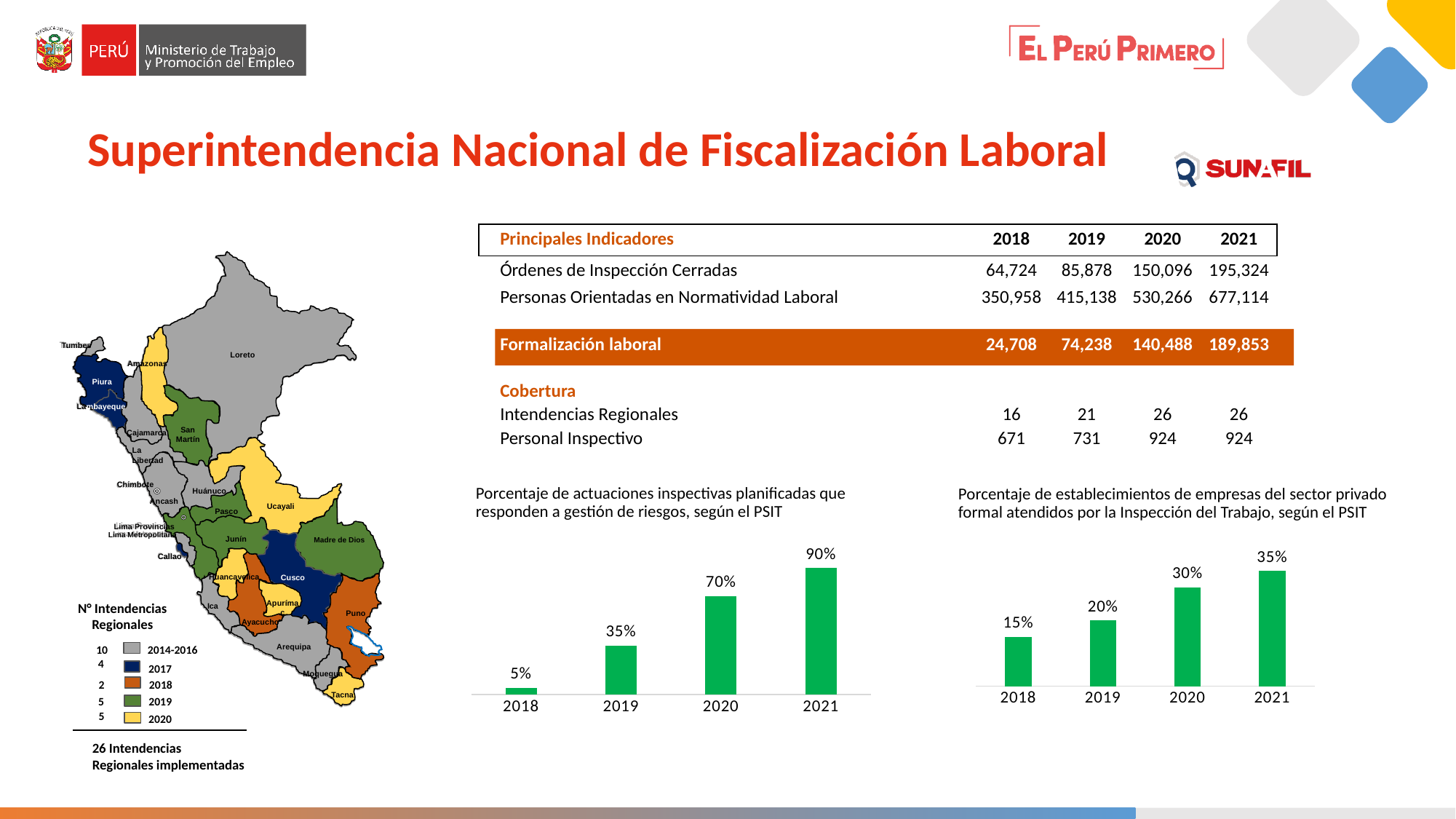
In the left chart (Porcentaje de actuaciones inspectivas planificadas que responden a gestión de riesgos), what is the value for 2018? 5% In the right chart (Porcentaje de establecimientos de empresas del sector privado formal atendidos por la Inspección del Trabajo), which year has the lowest value? 2018 In the right chart (Porcentaje de establecimientos de empresas del sector privado formal atendidos por la Inspección del Trabajo), how many years are plotted? 4 In the left chart (Porcentaje de actuaciones inspectivas planificadas que responden a gestión de riesgos), which year has the highest value? 2021 In the left chart (Porcentaje de actuaciones inspectivas planificadas que responden a gestión de riesgos), what is the difference between the 2021 and 2019 values? 55% Which is larger: the 2020 value in the left chart (actuaciones inspectivas planificadas) or the 2020 value in the right chart (establecimientos atendidos)? The left chart (70%) In the right chart (Porcentaje de establecimientos de empresas del sector privado formal atendidos por la Inspección del Trabajo), what is the difference between the 2020 and 2018 values? 15% In the left chart (Porcentaje de actuaciones inspectivas planificadas que responden a gestión de riesgos), what is the value for 2020? 70% In the left chart (Porcentaje de actuaciones inspectivas planificadas que responden a gestión de riesgos), do the values rise or fall from 2018 to 2021? rise What type of chart is the left chart (Porcentaje de actuaciones inspectivas planificadas que responden a gestión de riesgos)? Bar chart In the right chart (Porcentaje de establecimientos de empresas del sector privado formal atendidos por la Inspección del Trabajo), what is the value for 2019? 20% In the right chart (Porcentaje de establecimientos de empresas del sector privado formal atendidos por la Inspección del Trabajo), what is the value for 2021? 35%